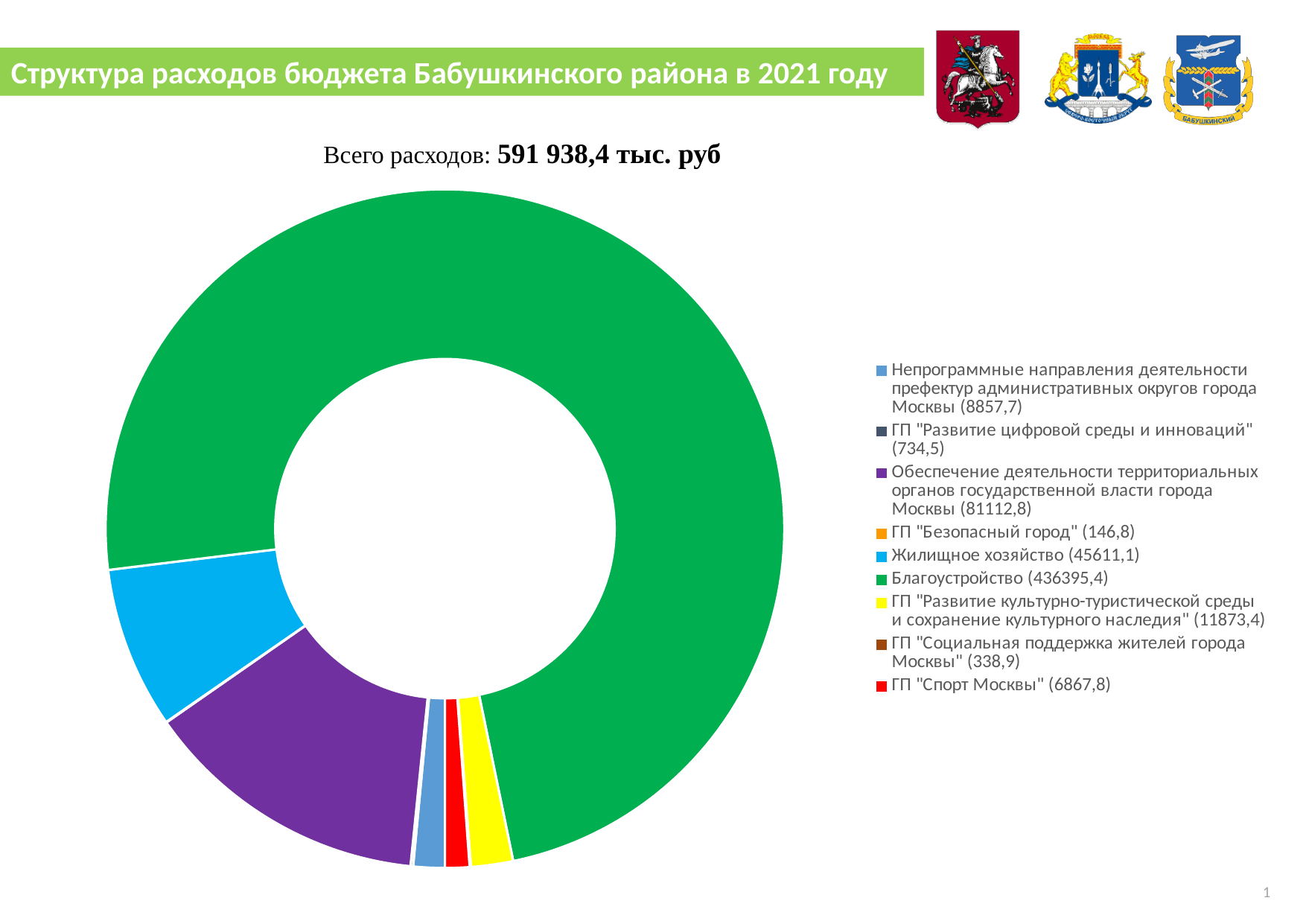
How many categories does the chart show? 9 What is the value for Благоустройство shown in the legend? 436395,4 Which is larger: Жилищное хозяйство or Обеспечение деятельности территориальных органов государственной власти города Москвы? Обеспечение деятельности территориальных органов государственной власти города Москвы Which category has the largest value? Благоустройство What is the difference between Обеспечение деятельности территориальных органов государственной власти города Москвы (81112,8) and Жилищное хозяйство (45611,1)? 35501,7 What is the value for Жилищное хозяйство? 45611,1 What is the value for ГП "Спорт Москвы"? 6867,8 Which category has the smallest value? ГП "Безопасный город" What colour is the Благоустройство slice? Green What is the total of all expenditures stated on the slide? 591 938,4 тыс. руб What kind of chart is shown on the slide? Pie (doughnut) chart What is the value for ГП "Безопасный город"? 146,8